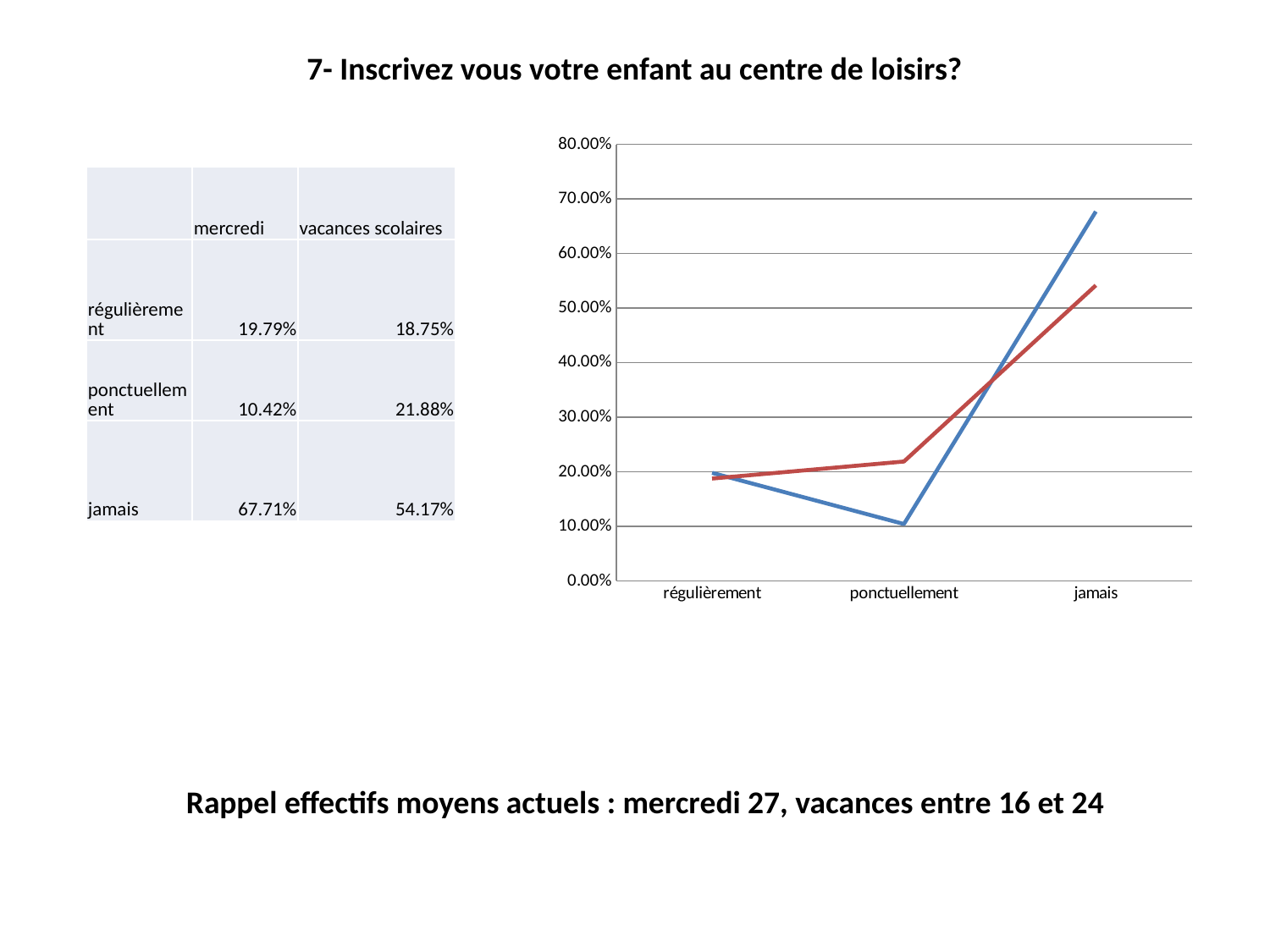
Is the value of the blue line at jamais greater or less than 60%? greater In the ponctuellement category, which is larger: mercredi or vacances scolaires? vacances scolaires Which category has the lowest value for mercredi? ponctuellement What kind of chart is shown on the slide? line chart Which colour line reaches the highest point on the chart? blue Which category has the highest value for mercredi? jamais How many categories are shown on the x axis of the chart? 3 According to the slide, what is the value for mercredi in the jamais category? 67.71% Is the value of the red line at ponctuellement greater or less than 30%? less According to the slide, what is the value for vacances scolaires in the ponctuellement category? 21.88% Does the blue line rise or fall from ponctuellement to jamais? rise What is the difference between the mercredi and vacances scolaires values for jamais? 13.54%